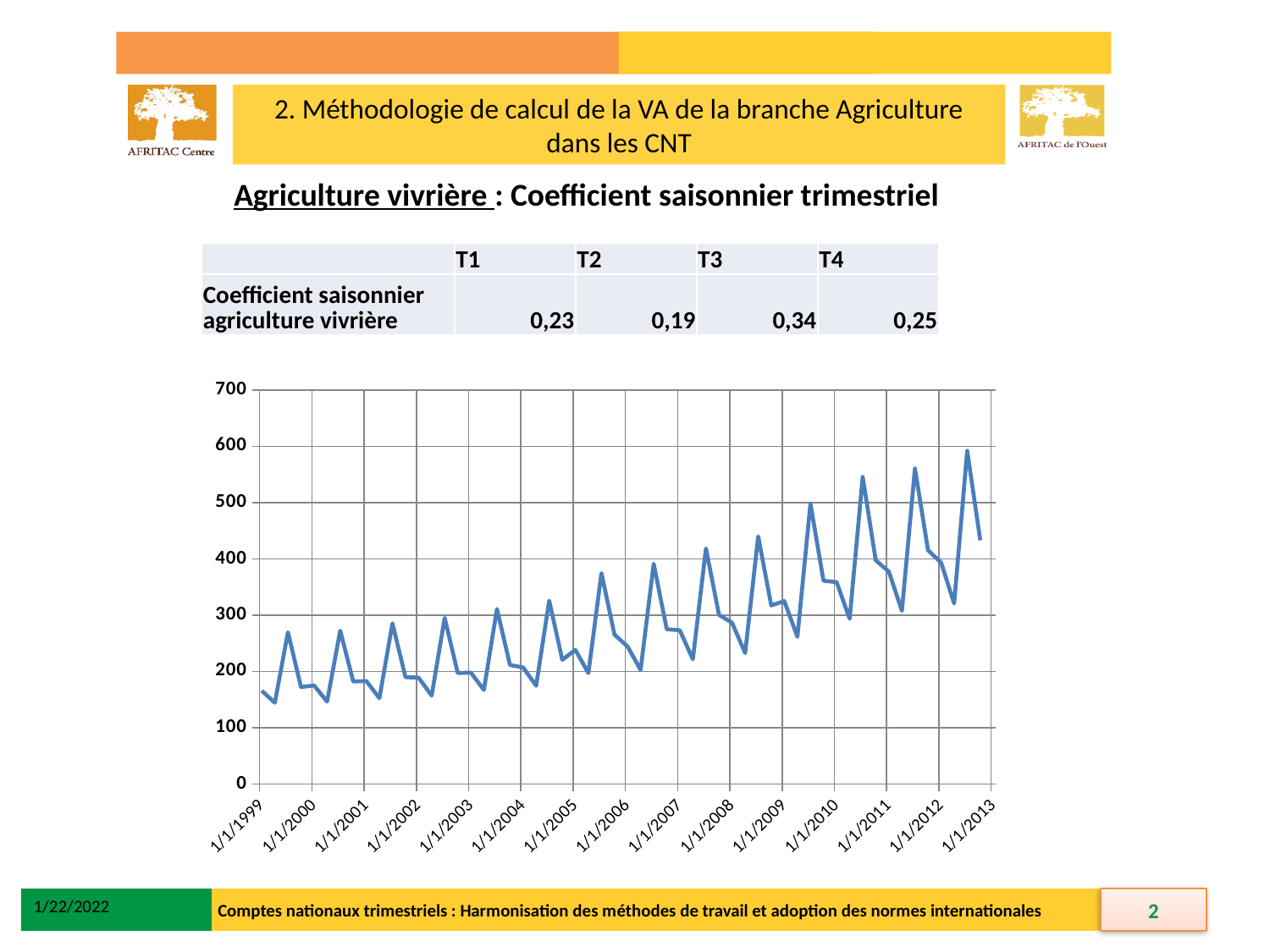
How many date labels are shown on the x axis of the line chart? 15 Overall, do the values on the line chart rise or fall from 1/1/1999 to 1/1/2013? rise Is the highest peak of the line chart greater or less than 500? greater Is the value at 1/1/1999 on the line chart greater or less than 200? less Is the lowest point of the line chart greater or less than 200? less Does the highest point of the line chart occur near the beginning or near the end of the x axis? near the end What kind of chart is shown on the slide? line chart What is the highest value shown on the y axis of the line chart? 700 What is the first date label on the x axis of the line chart? 1/1/1999